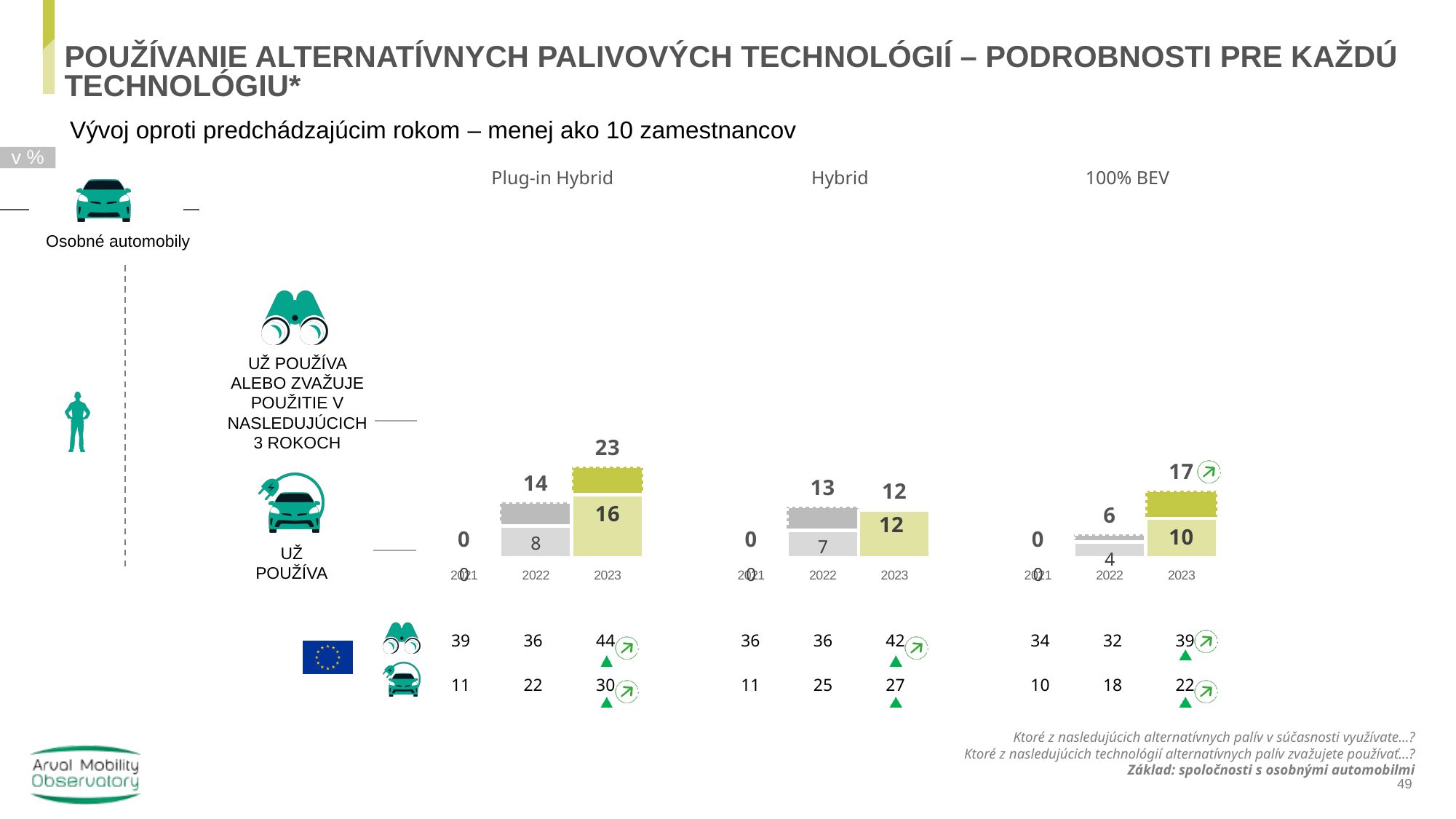
In the Plug-in Hybrid chart, what is the value for 'Už používa' in 2023? 16 In the Plug-in Hybrid chart, what is the value for 'Už používa alebo zvažuje použitie v nasledujúcich 3 rokoch' in 2023? 23 In the Plug-in Hybrid chart, which year has the highest value for 'Už používa alebo zvažuje použitie v nasledujúcich 3 rokoch'? 2023 In the 100% BEV chart, what is the value for 'Už používa' in 2023? 10 In the 100% BEV chart, what is the value for 'Už používa alebo zvažuje použitie v nasledujúcich 3 rokoch' in 2022? 6 In the Hybrid chart, which year has the lowest value for 'Už používa'? 2021 In the Hybrid chart, what is the value for 'Už používa' in 2022? 7 In the 100% BEV chart, what is the difference between the 'Už používa alebo zvažuje použitie v nasledujúcich 3 rokoch' values for 2023 and 2022? 11 How many years are shown on the x axis of the Hybrid chart? 3 What kind of chart is used for the Plug-in Hybrid data? Bar chart In the Plug-in Hybrid chart, what is the difference between the 'Už používa' values for 2023 and 2022? 8 Which is larger: the 2023 'Už používa' value in the Plug-in Hybrid chart or in the Hybrid chart? Plug-in Hybrid